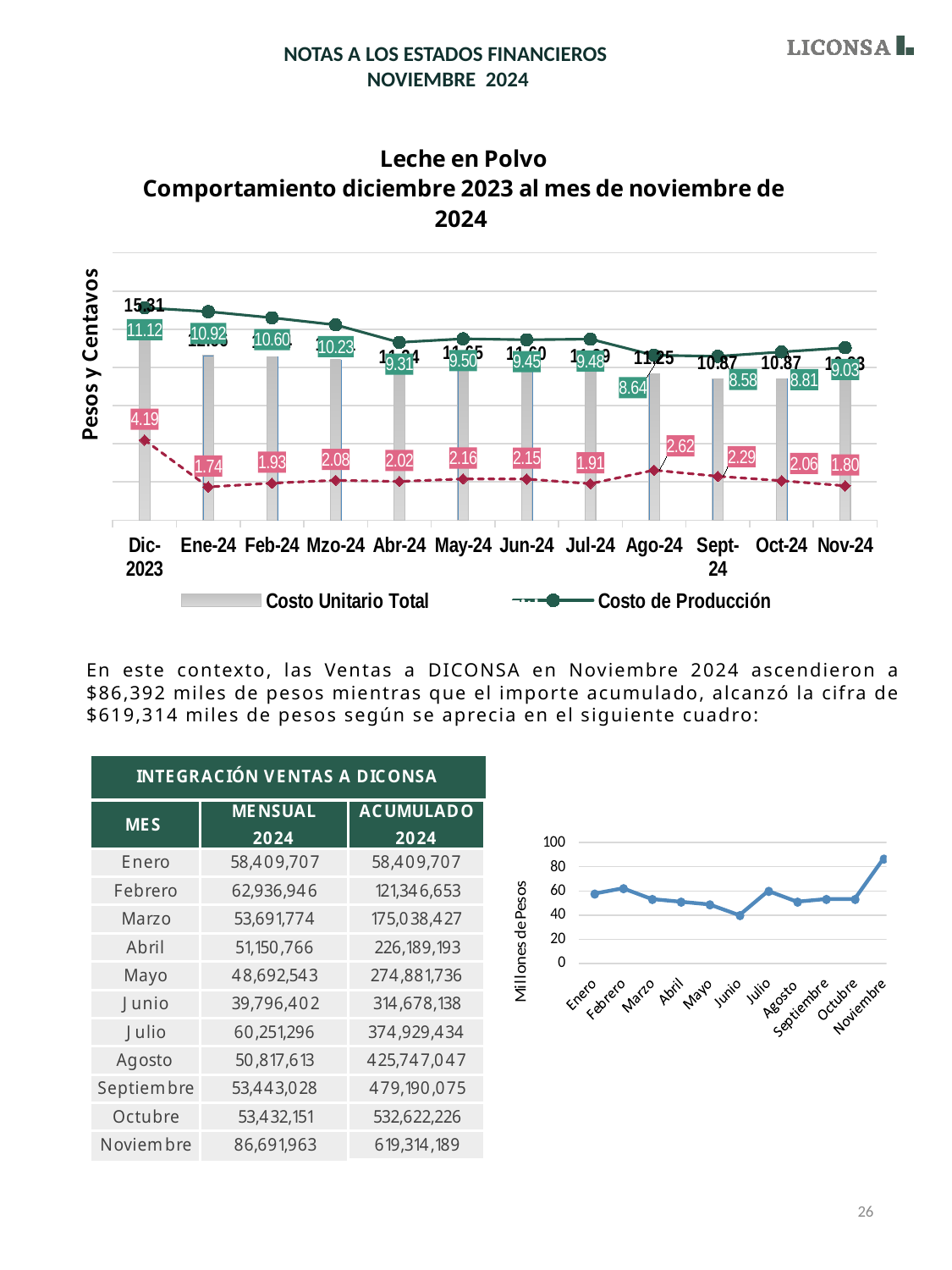
In the 'Leche en Polvo' chart, what is the Costo de Producción value for Dic-2023? 11.12 In the 'Leche en Polvo' chart, what is the Costo de Producción value for Nov-24? 9.03 In the bottom line chart (Millones de Pesos), which month has the highest value? Noviembre In the 'Leche en Polvo' chart, what is the Costo Unitario Total value for Dic-2023? 15.31 How many series does the legend of the 'Leche en Polvo' chart list? 2 In the 'Leche en Polvo' chart, what is the difference between the Costo de Producción for Dic-2023 and Nov-24? 2.09 In the 'Leche en Polvo' chart, what is the Costo Unitario Total value for May-24? 11.65 In the bottom line chart (Millones de Pesos), which month has the lowest value? Junio In the 'Leche en Polvo' chart, which month has the lowest Costo de Producción? Sept-24 In the bottom line chart (Millones de Pesos), is the value for Noviembre greater or less than 80? greater How many months are shown on the x axis of the 'Leche en Polvo' chart? 12 In the 'Leche en Polvo' chart, which is larger, the Costo de Producción for Feb-24 or for Mzo-24? Feb-24